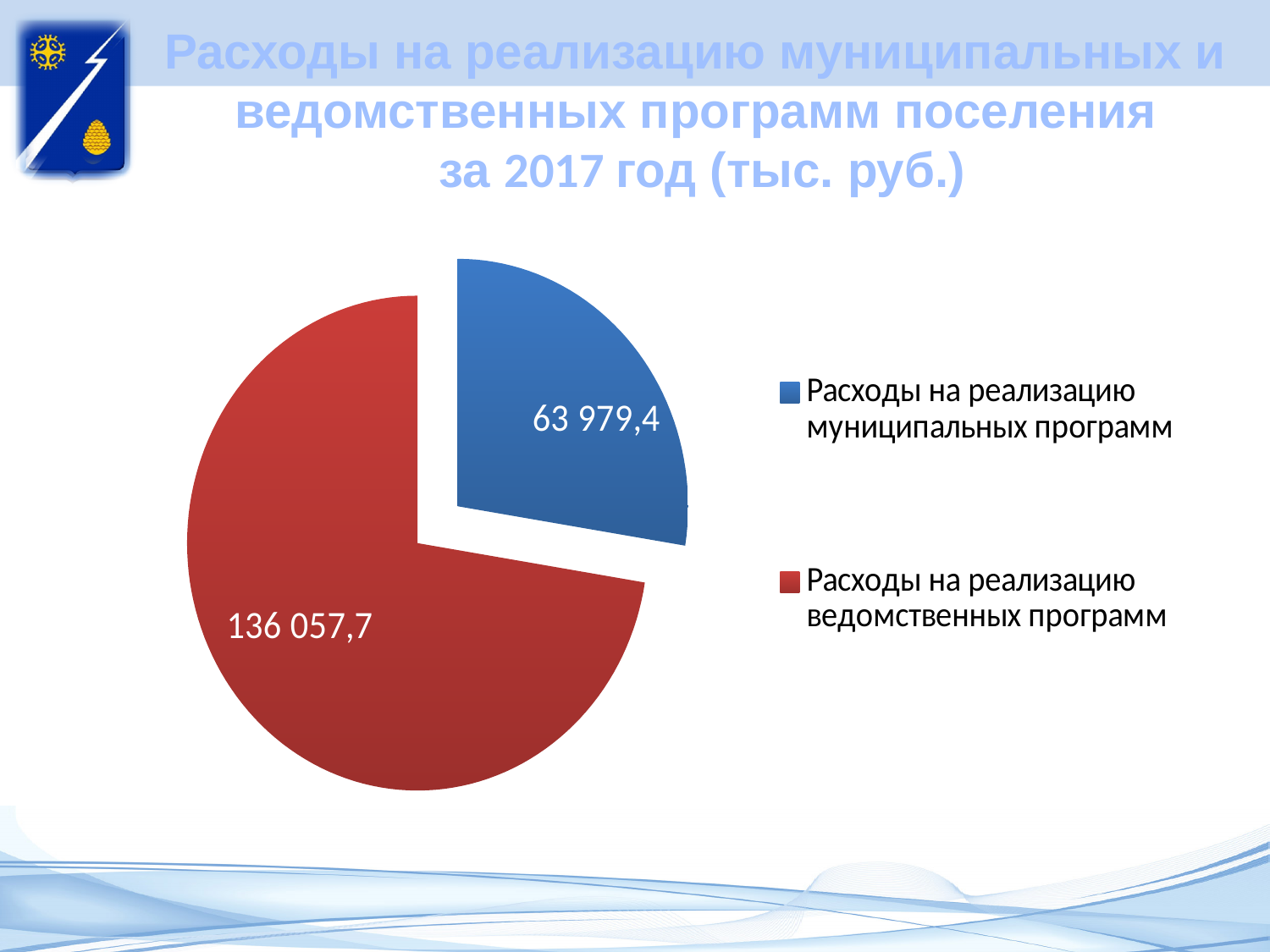
What is the value for "Расходы на реализацию ведомственных программ"? 136 057,7 What type of chart is shown on the slide? Pie chart What is the difference between the value for departmental programs and the value for municipal programs? 72 078,3 Which category has the largest slice of the pie? Расходы на реализацию ведомственных программ How many slices does the pie chart have? 2 How many entries does the legend list? 2 In what units are the values on the chart given, according to the slide title? тыс. руб. What is the total of the two slices in the pie chart? 200 037,1 What is the value for "Расходы на реализацию муниципальных программ"? 63 979,4 What colour is the slice for "Расходы на реализацию муниципальных программ"? Blue Which category has the smallest slice of the pie? Расходы на реализацию муниципальных программ Which is larger: expenses on municipal programs or expenses on departmental programs? Расходы на реализацию ведомственных программ